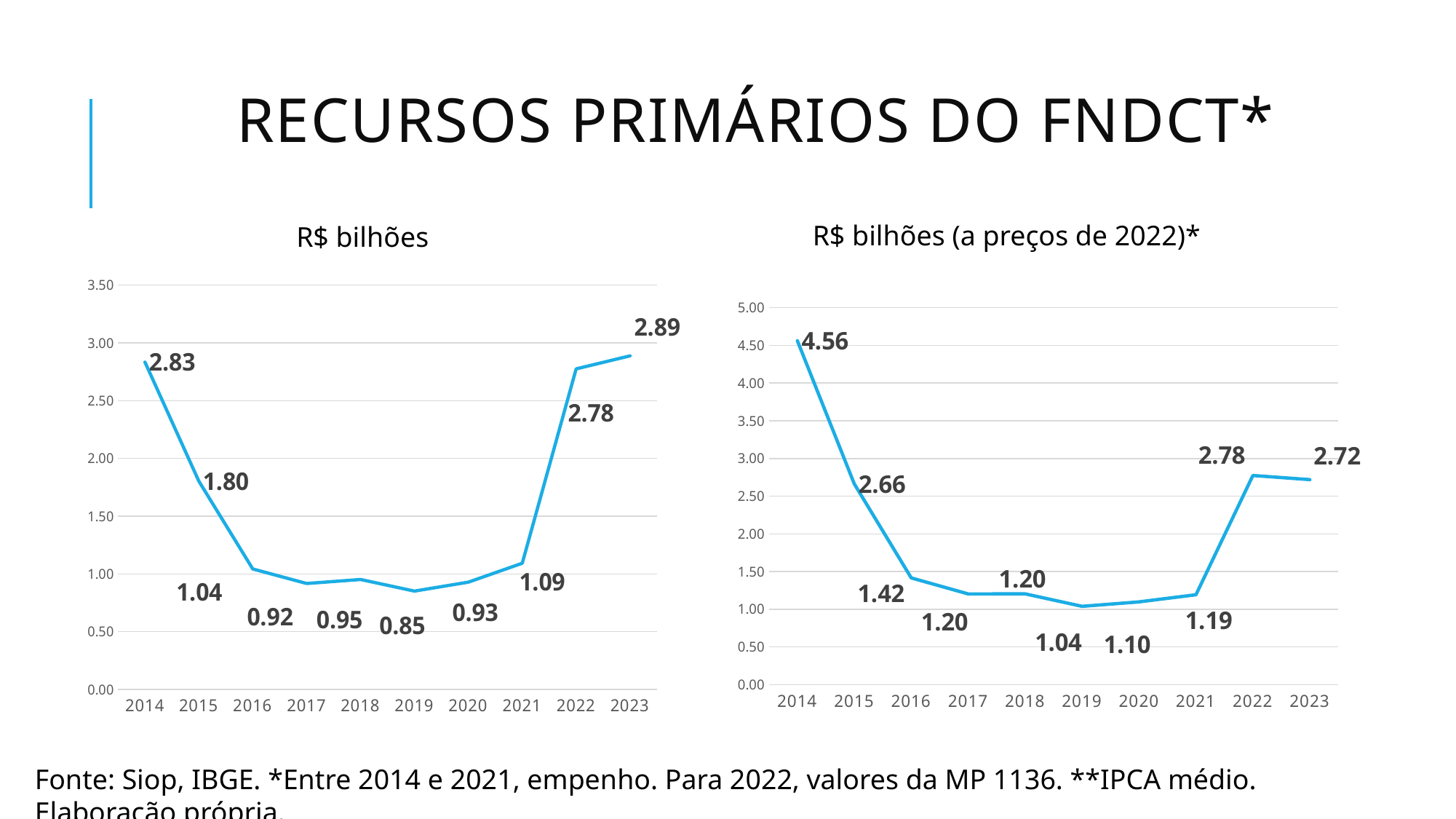
How many years are plotted in the chart titled "R$ bilhões"? 10 In the chart titled "R$ bilhões (a preços de 2022)*", what is the difference between the values for 2014 and 2015? 1.90 In the chart titled "R$ bilhões (a preços de 2022)*", what is the value for 2021? 1.19 In the chart titled "R$ bilhões (a preços de 2022)*", what is the value for 2014? 4.56 In the chart titled "R$ bilhões", what is the value for 2014? 2.83 In the chart titled "R$ bilhões (a preços de 2022)*", which is larger, the value for 2022 or the value for 2023? 2022 In the chart titled "R$ bilhões", which year has the highest value? 2023 In the chart titled "R$ bilhões (a preços de 2022)*", which year has the lowest value? 2019 In the chart titled "R$ bilhões", what is the difference between the values for 2023 and 2022? 0.11 What kind of chart is the chart titled "R$ bilhões (a preços de 2022)*"? Line chart In the chart titled "R$ bilhões", what is the value for 2019? 0.85 In the chart titled "R$ bilhões", which year has the lowest value? 2019